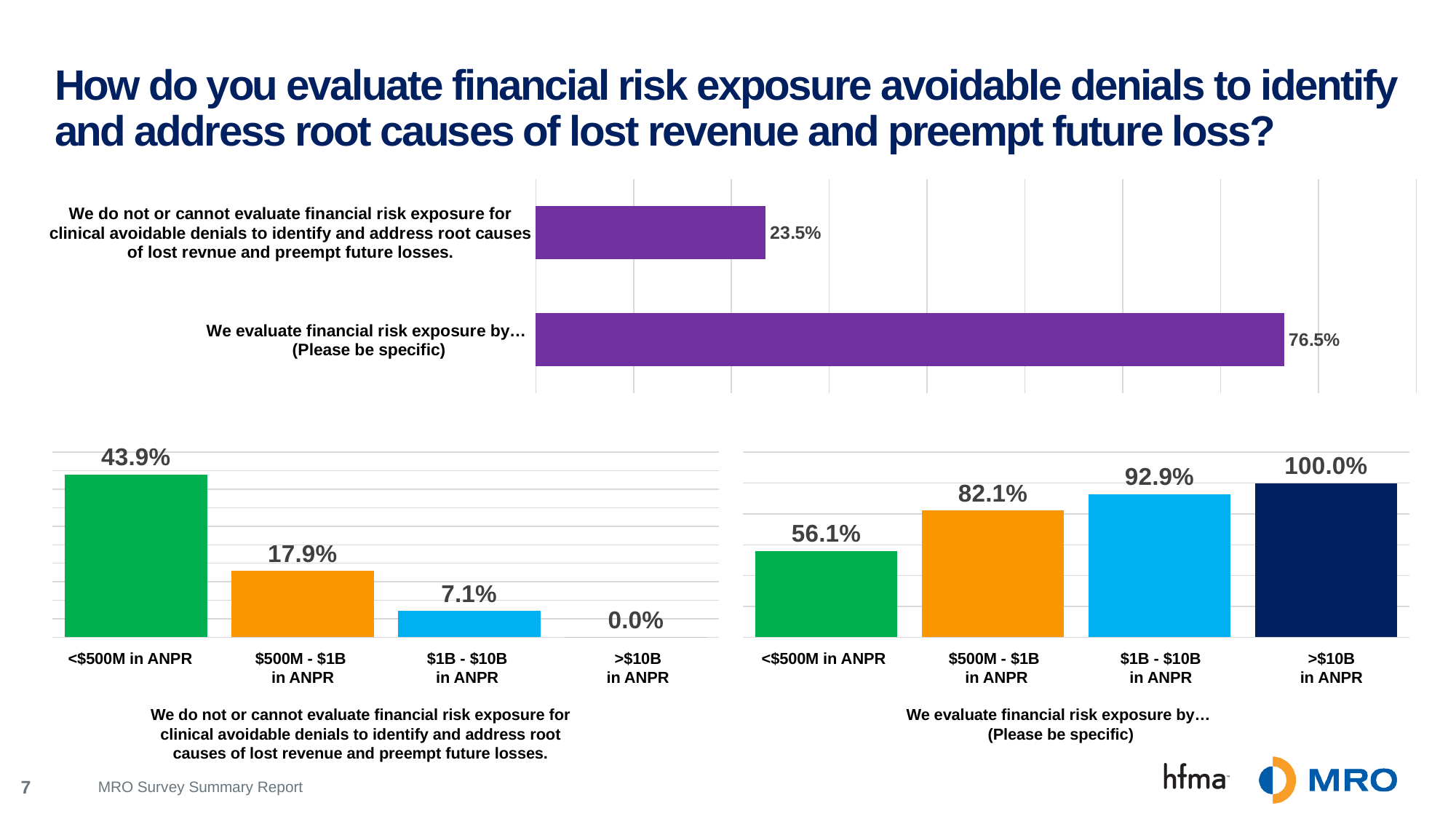
In the bottom-right chart ("We evaluate financial risk exposure by…"), which is larger: <$500M in ANPR or $500M - $1B in ANPR? $500M - $1B in ANPR In the bottom-right chart ("We evaluate financial risk exposure by…"), which category has the highest value? >$10B in ANPR In the top horizontal bar chart, what is the value for "We do not or cannot evaluate financial risk exposure..."? 23.5% In the top horizontal bar chart, what is the value for "We evaluate financial risk exposure by… (Please be specific)"? 76.5% How many categories are shown in the bottom-left chart ("We do not or cannot evaluate financial risk exposure...")? 4 In the bottom-left chart ("We do not or cannot evaluate financial risk exposure..."), which category has the lowest value? >$10B in ANPR In the bottom-right chart ("We evaluate financial risk exposure by…"), do the values rise or fall from left to right across the categories? rise In the bottom-left chart ("We do not or cannot evaluate financial risk exposure..."), what is the value for <$500M in ANPR? 43.9% In the bottom-right chart ("We evaluate financial risk exposure by…"), what is the value for $1B - $10B in ANPR? 92.9% In the top horizontal bar chart, what is the difference between the two bars? 53.0% What kind of chart is the top chart on the slide? bar chart In the bottom-left chart ("We do not or cannot evaluate financial risk exposure..."), what is the difference between <$500M in ANPR and $500M - $1B in ANPR? 26.0%